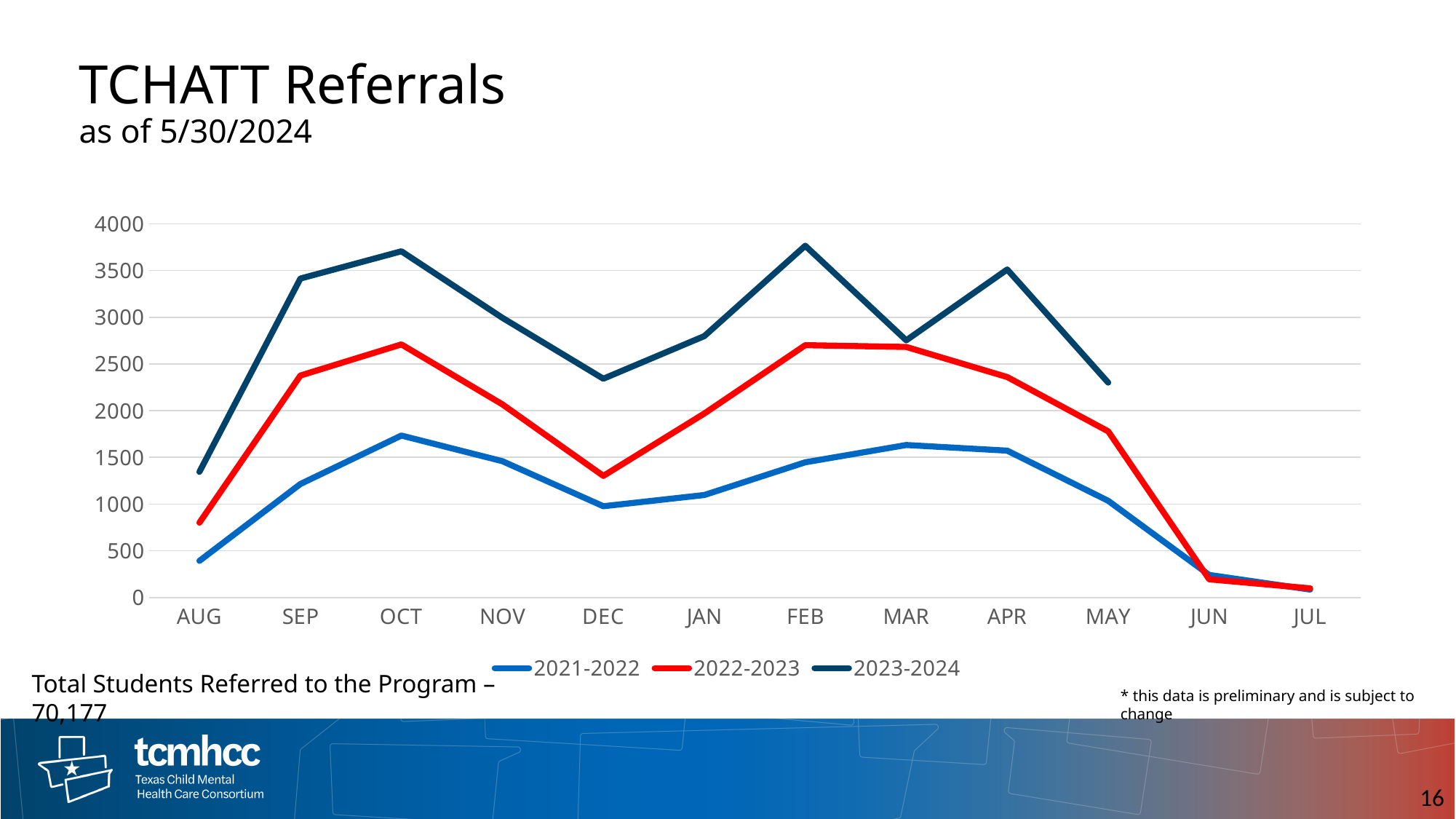
Which month has the highest value for the 2021-2022 series? OCT Which month has the lowest value for the 2022-2023 series? JUL Which month has the lowest value for the 2023-2024 series? AUG How many months are shown along the x axis? 12 How many series does the legend list? 3 What kind of chart is shown on the slide? line chart In OCT, which series has the larger value, 2023-2024 or 2022-2023? 2023-2024 Is the value for 2021-2022 in AUG greater or less than 500? less Is the value for 2023-2024 in SEP greater or less than 3000? greater What is the title of the chart? TCHATT Referrals Is the value for 2022-2023 in DEC greater or less than 1500? less Does the 2023-2024 series rise or fall from FEB to MAR? fall